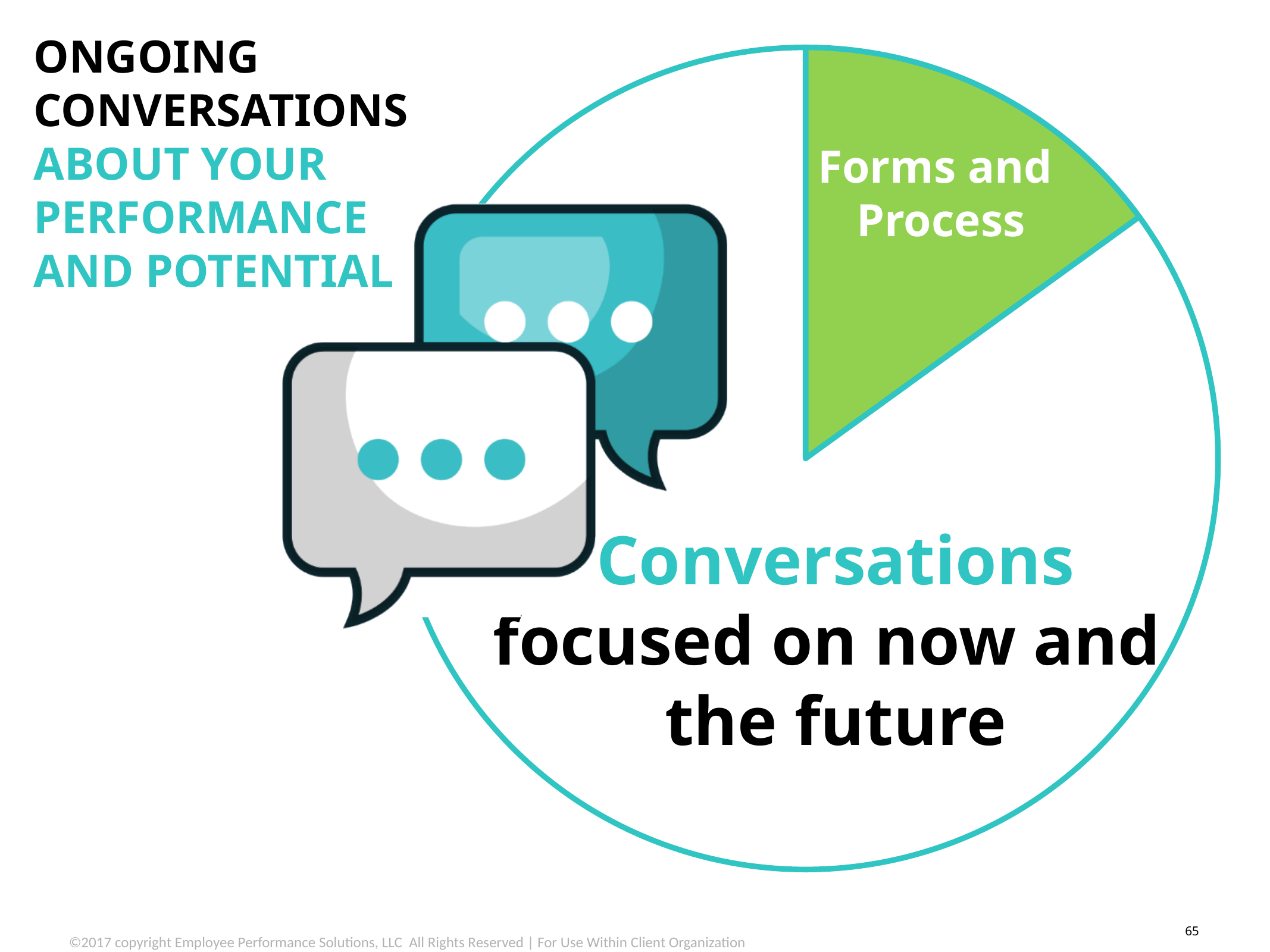
What is the label of the green slice in the pie chart? Forms and Process How many slices does the pie chart have? 2 Which slice of the pie chart is the smallest? Forms and Process What colour is the "Forms and Process" slice of the pie chart? green Which slice of the pie chart is larger, "Forms and Process" or "Conversations focused on now and the future"? Conversations focused on now and the future Which slice of the pie chart is the largest? Conversations focused on now and the future What kind of chart is shown on the slide? pie chart